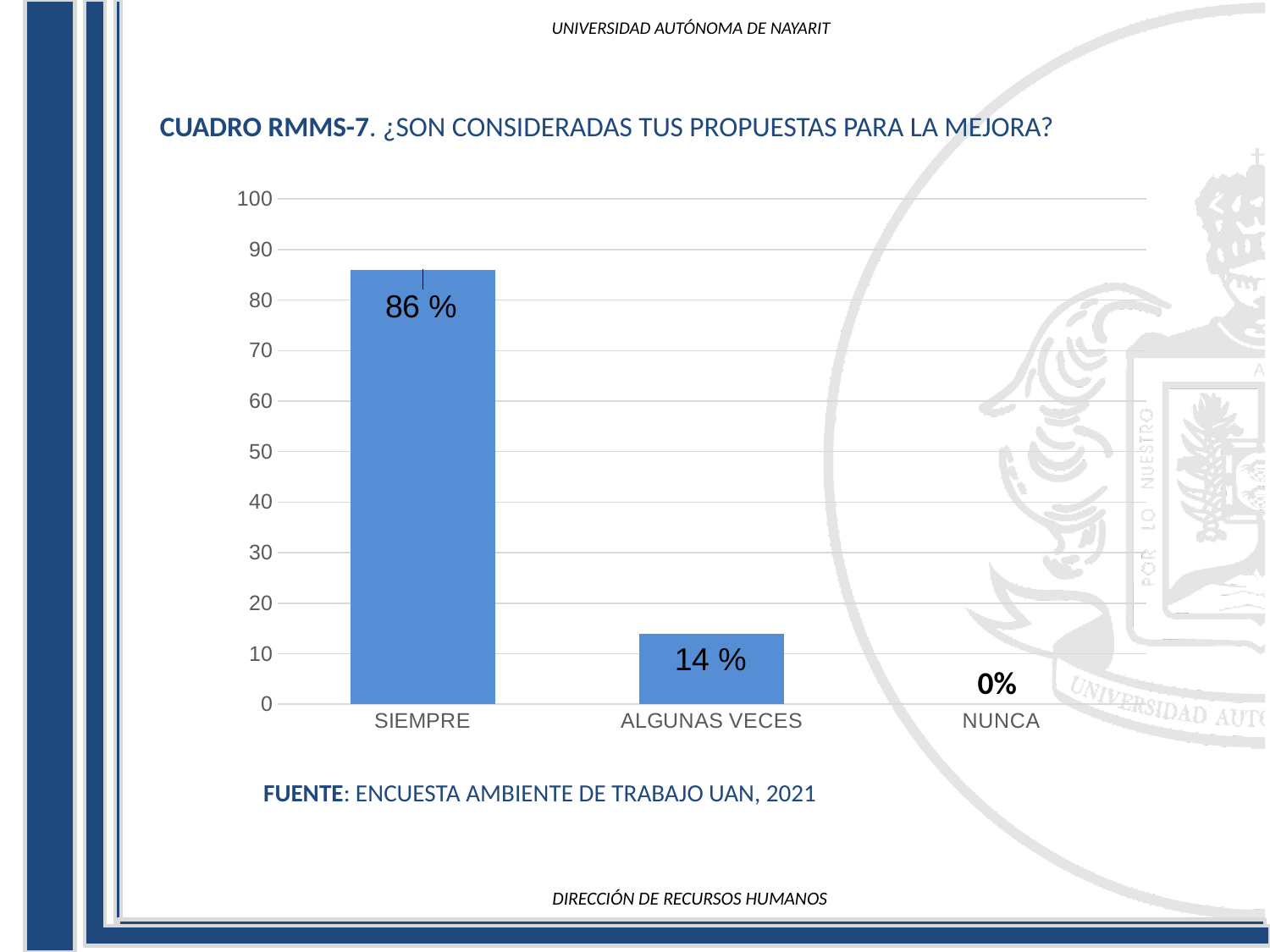
Is the value for SIEMPRE greater or less than 80? greater Which is larger, the value for SIEMPRE or the value for ALGUNAS VECES? SIEMPRE Which category has the highest value? SIEMPRE How many categories are shown on the x axis? 3 Is the value for ALGUNAS VECES greater or less than 20? less What is the difference between the values for SIEMPRE and ALGUNAS VECES? 72 % What is the value for SIEMPRE? 86 % What kind of chart is shown on the slide? bar chart What is the source cited below the chart? ENCUESTA AMBIENTE DE TRABAJO UAN, 2021 What is the value for NUNCA? 0% Which category has the lowest value? NUNCA What is the value for ALGUNAS VECES? 14 %